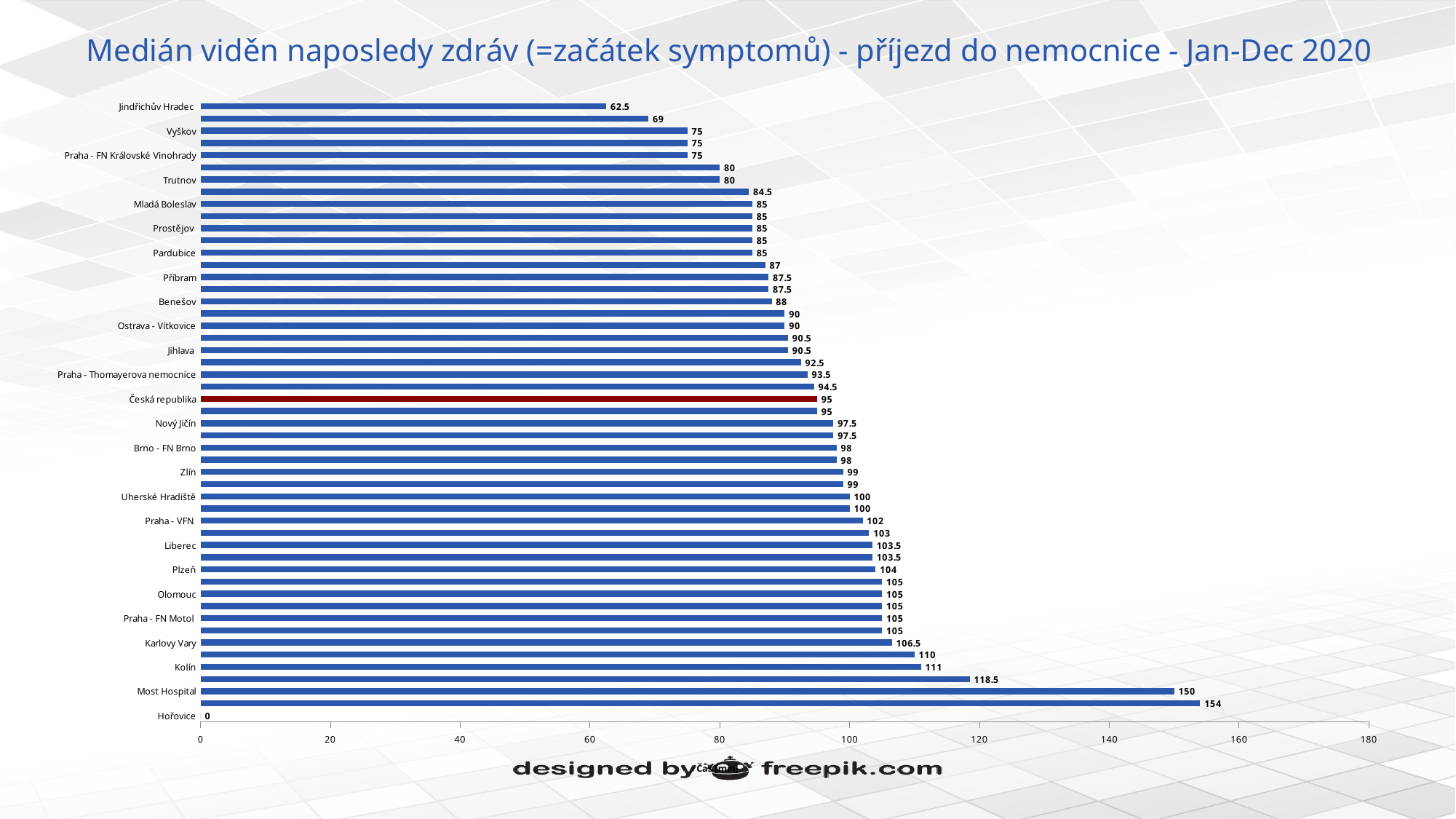
What is the value for Česká republika? 95 What is the value for Karlovy Vary? 106.5 What is the value for Kolín? 111 What is the value for Praha - Thomayerova nemocnice? 93.5 What is the difference between the values for Kolín and Jindřichův Hradec? 48.5 What is the difference between the values for Most Hospital and Česká republika? 55 Is the value for Trutnov greater or less than 100? less What type of chart is shown on the slide? bar chart What is the value for Jindřichův Hradec? 62.5 What is the value for Most Hospital? 150 Which category's bar is highlighted in red? Česká republika Which is larger, the value for Plzeň or the value for Benešov? Plzeň